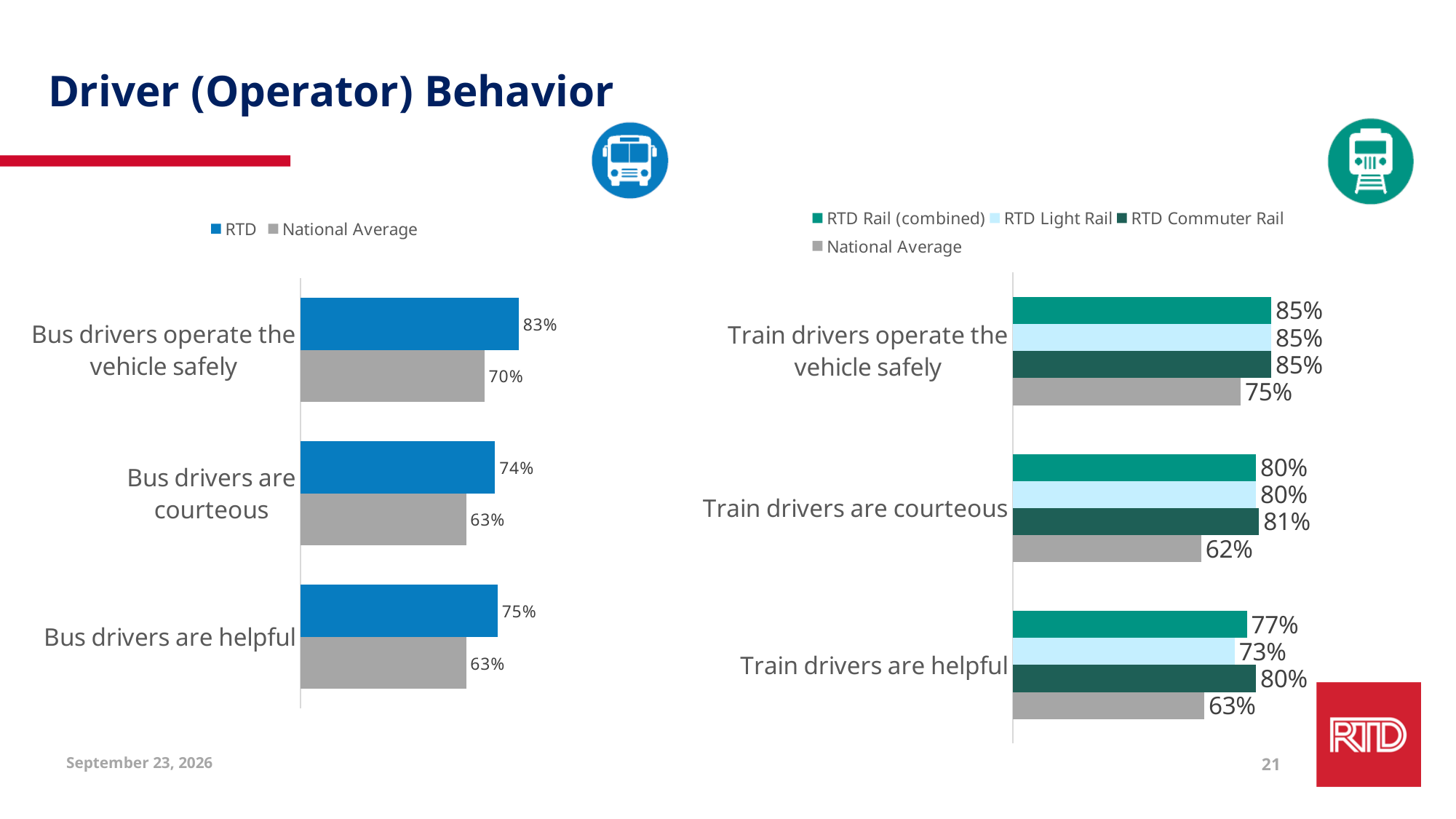
In the right (train) chart, how many series does the legend list? 4 In the right (train) chart, which is larger for 'Train drivers are helpful': RTD Light Rail or RTD Commuter Rail? RTD Commuter Rail In the left (bus) chart, how many series does the legend list? 2 In the right (train) chart, what is the difference between the RTD Rail (combined) and National Average values for 'Train drivers operate the vehicle safely'? 10 percentage points In the right (train) chart, which category has the lowest National Average value? Train drivers are courteous In the left (bus) chart, what is the RTD value for 'Bus drivers operate the vehicle safely'? 83% What kind of chart is the left (bus) chart? Bar chart In the left (bus) chart, which category has the highest RTD value? Bus drivers operate the vehicle safely In the right (train) chart, what is the RTD Light Rail value for 'Train drivers are helpful'? 73% In the left (bus) chart, what is the difference between the RTD and National Average values for 'Bus drivers are helpful'? 12 percentage points In the left (bus) chart, what is the National Average value for 'Bus drivers are courteous'? 63% In the right (train) chart, what is the RTD Commuter Rail value for 'Train drivers are courteous'? 81%